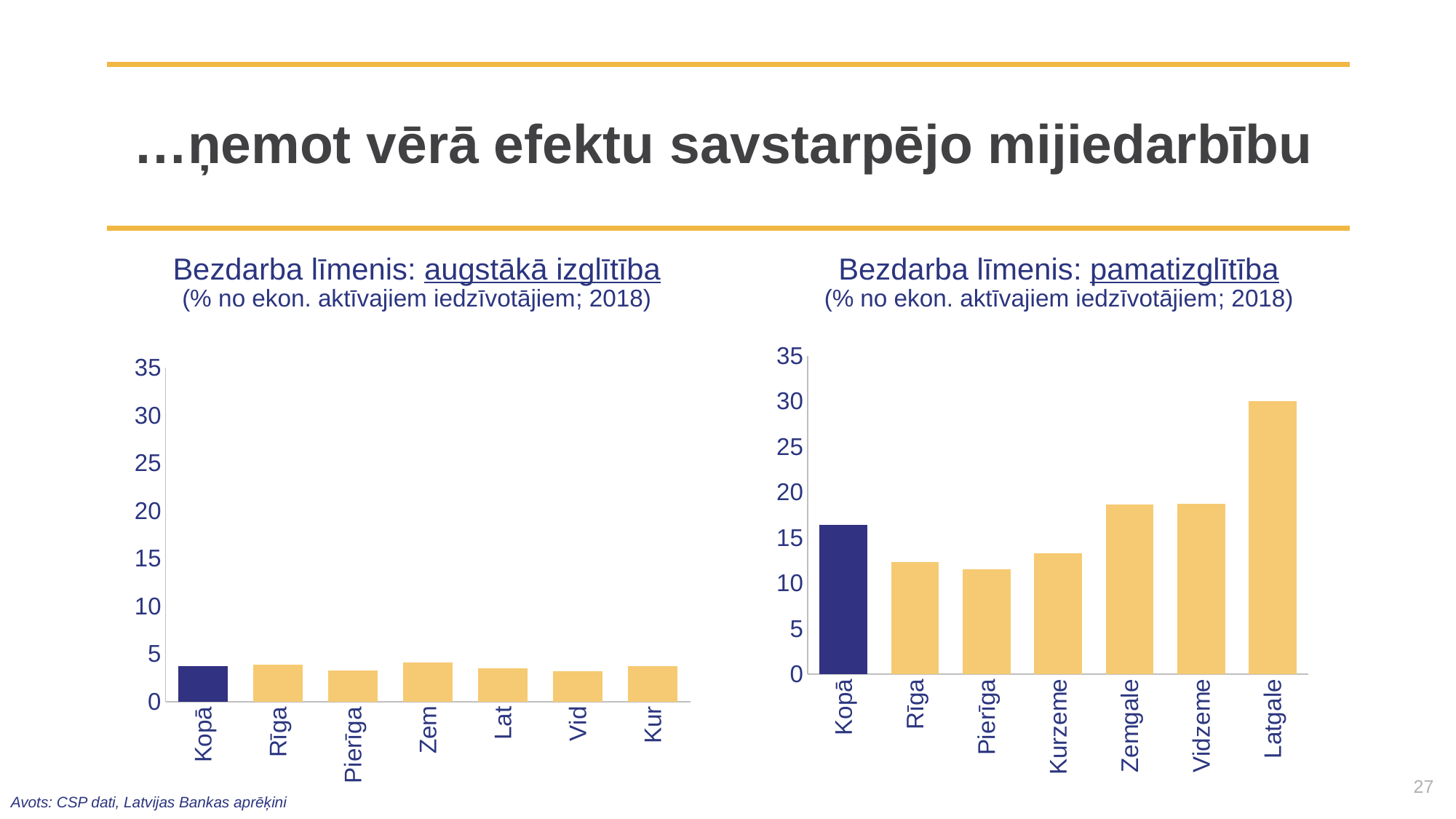
What is the title of the right chart? Bezdarba līmenis: pamatizglītība On the right chart, 'Bezdarba līmenis: pamatizglītība', is the value for Latgale greater or less than 25? greater On the right chart, 'Bezdarba līmenis: pamatizglītība', is the value for Pierīga greater or less than 15? less On the left chart, 'Bezdarba līmenis: augstākā izglītība', is the value for Zem greater or less than 10? less On the right chart, 'Bezdarba līmenis: pamatizglītība', which category has the highest value? Latgale How many categories are shown on the right chart, 'Bezdarba līmenis: pamatizglītība'? 7 How many categories are shown on the left chart, 'Bezdarba līmenis: augstākā izglītība'? 7 What kind of chart is the left chart, 'Bezdarba līmenis: augstākā izglītība'? bar chart On the right chart, 'Bezdarba līmenis: pamatizglītība', which is larger, the value for Kopā or the value for Kurzeme? Kopā On the right chart, 'Bezdarba līmenis: pamatizglītība', which is larger, the value for Zemgale or the value for Rīga? Zemgale